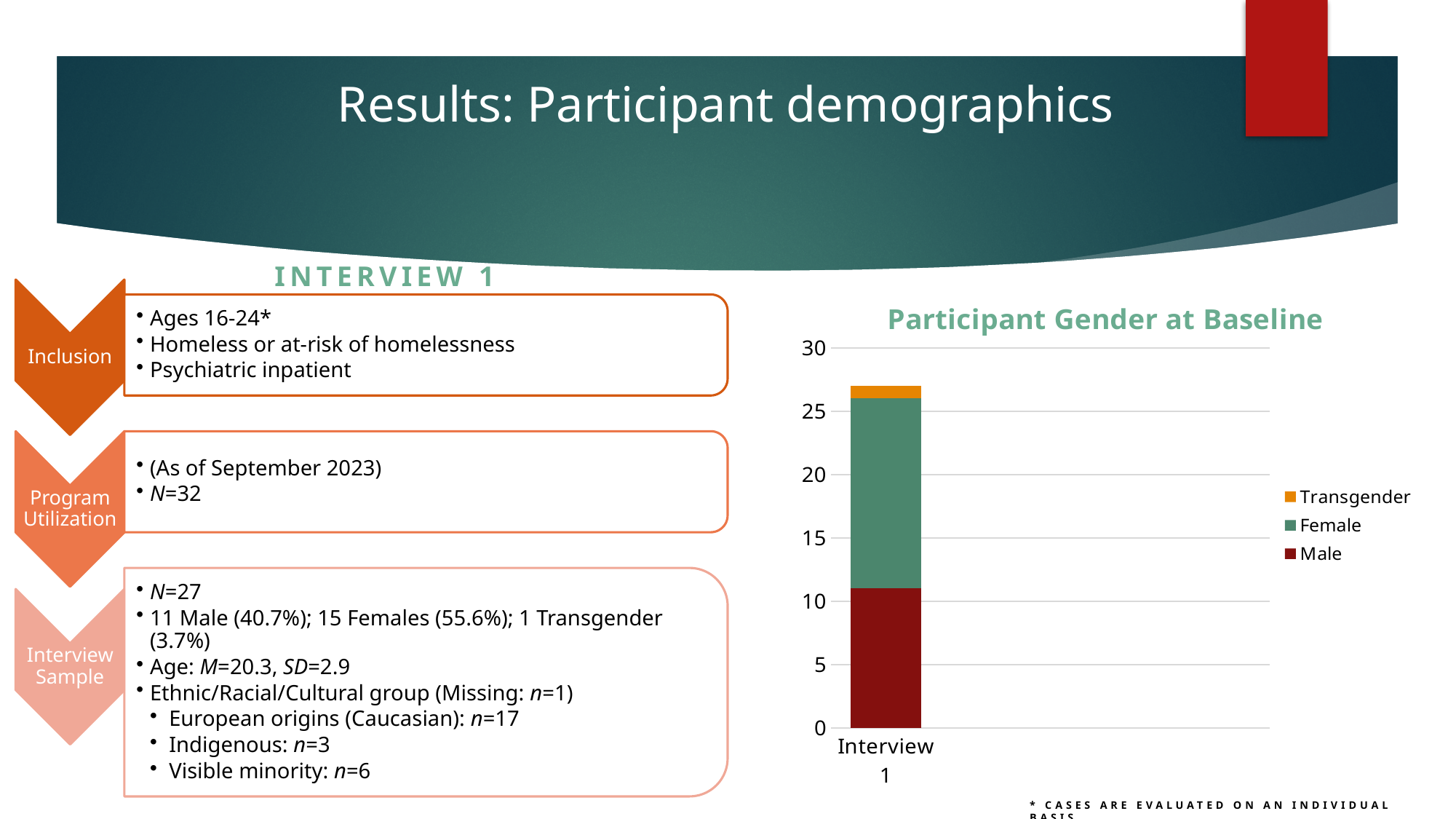
In the "Participant Gender at Baseline" chart, is the total height of the stacked bar greater or less than 25? greater What type of chart is shown under the title "Participant Gender at Baseline"? stacked bar chart Which series are listed in the legend of the "Participant Gender at Baseline" chart? Transgender, Female, Male In the "Participant Gender at Baseline" chart, which gender series has the largest segment? Female How many categories are shown on the x axis of the "Participant Gender at Baseline" chart? 1 In the "Participant Gender at Baseline" chart, is the total height of the stacked bar greater or less than 30? less In the "Participant Gender at Baseline" chart, is the value for Male greater or less than 10? greater How many series does the legend of the "Participant Gender at Baseline" chart list? 3 What is the category label on the x axis of the "Participant Gender at Baseline" chart? Interview 1 In the "Participant Gender at Baseline" chart, which gender series has the smallest segment? Transgender In the "Participant Gender at Baseline" chart, is the Female segment larger or smaller than the Male segment? larger